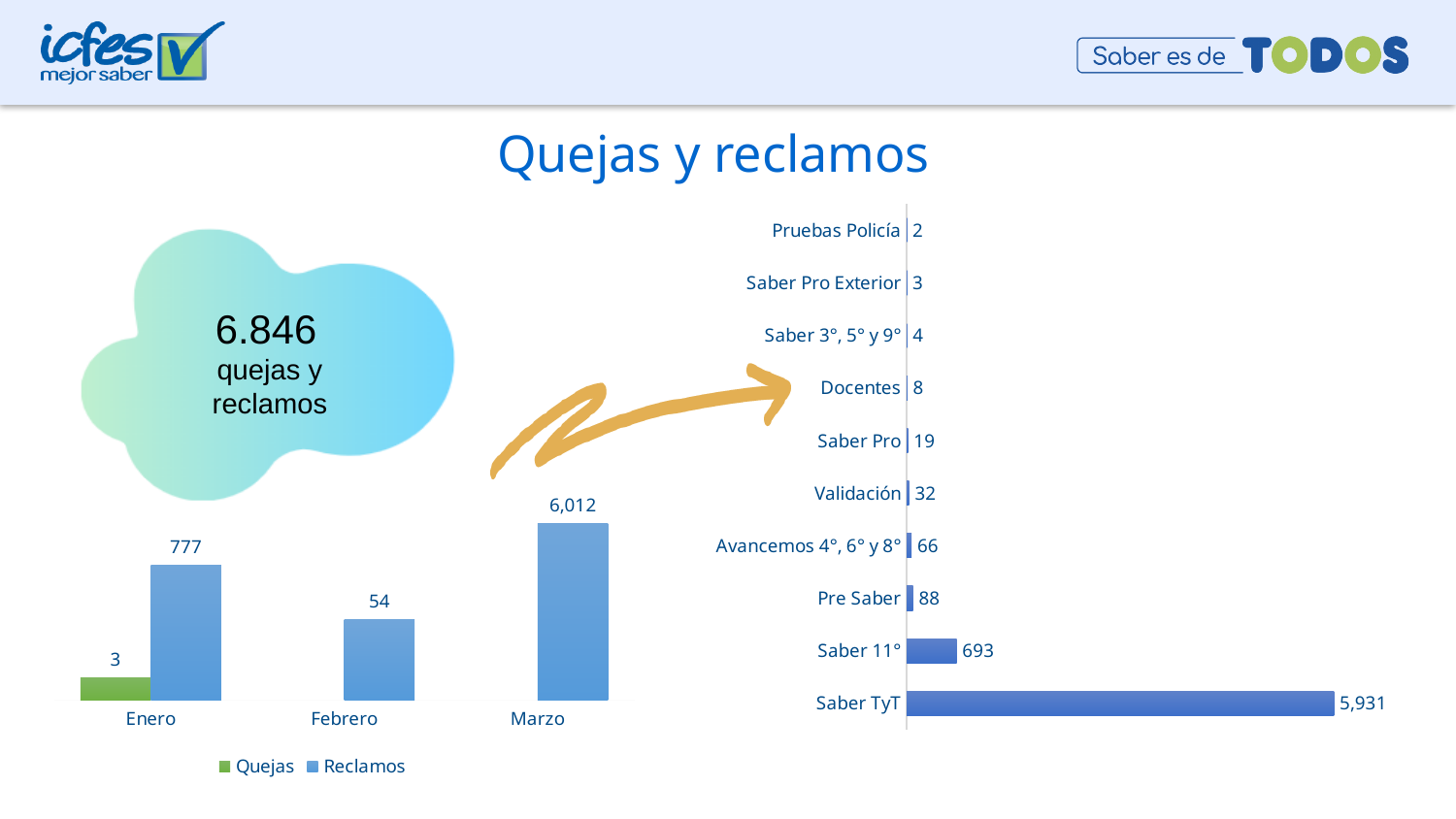
In the left chart (by month), how many series does the legend list? 2 In the left chart (by month), which month has the highest Reclamos value? Marzo In the left chart (by month), what is the difference between the Reclamos values for Enero and Febrero? 723 In the right chart (by test type), what is the value for Saber 11°? 693 In the right chart (by test type), how many categories are shown? 10 In the right chart (by test type), which is larger, the value for Pre Saber or the value for Validación? Pre Saber In the right chart (by test type), what is the value for Saber TyT? 5,931 What kind of chart is the right chart (by test type)? Bar chart In the left chart (by month), what is the value of Reclamos for Enero? 777 In the left chart (by month), what is the value of Quejas for Enero? 3 In the left chart (by month), what is the value of Reclamos for Marzo? 6,012 In the right chart (by test type), which category has the lowest value? Pruebas Policía